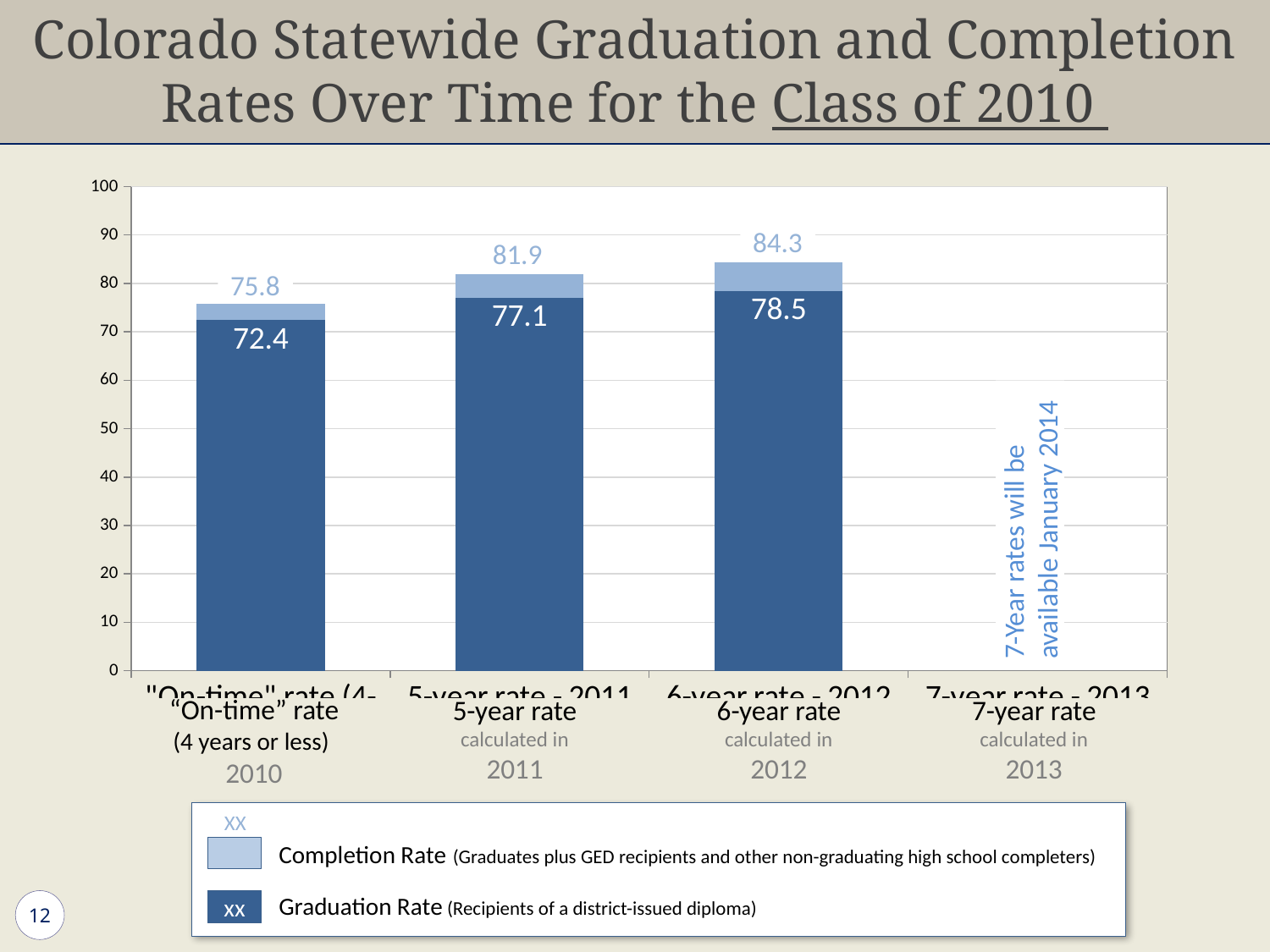
What is the difference between the completion rate and the graduation rate for the "On-time" rate category? 3.4 What kind of chart is shown on the slide? Stacked bar chart What is the completion rate shown for the 6-year rate calculated in 2012? 84.3 What is the difference between the 6-year graduation rate and the 5-year graduation rate? 1.4 Which is larger, the 5-year completion rate or the 6-year graduation rate? 5-year completion rate Which category with plotted data has the lowest completion rate? "On-time" rate (4 years or less) 2010 What is the graduation rate shown for the "On-time" rate (4 years or less) category? 72.4 Which category has the highest graduation rate? 6-year rate calculated in 2012 What is the completion rate shown for the 5-year rate calculated in 2011? 81.9 Do the graduation rates rise or fall from the "On-time" rate to the 6-year rate? Rise What is the graduation rate shown for the 5-year rate calculated in 2011? 77.1 How many series does the legend list? 2